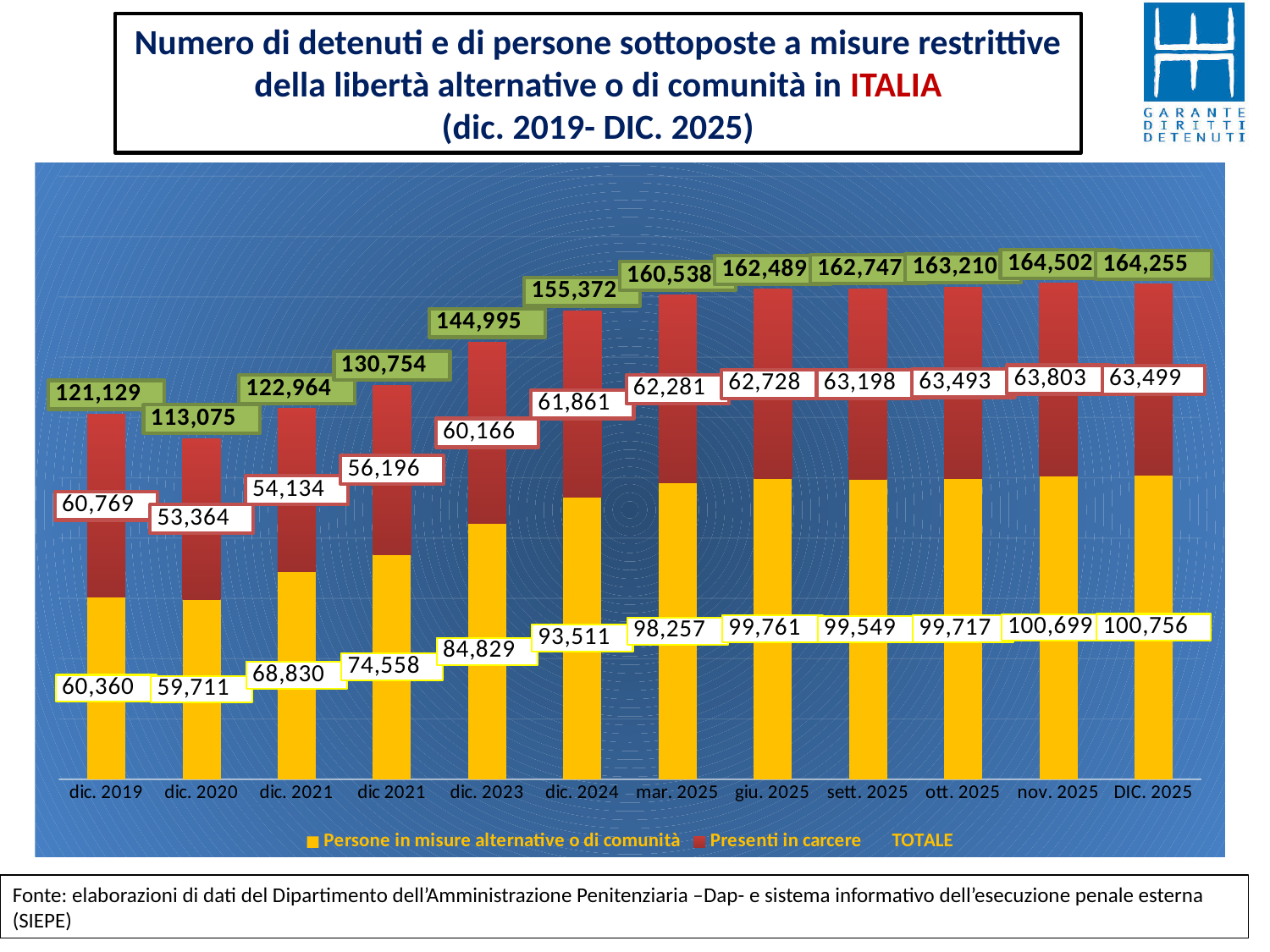
How many series does the legend list? 3 What is the value of 'Persone in misure alternative o di comunità' for dic. 2024? 93,511 What type of chart is shown on the slide? stacked bar chart Which period has the highest TOTALE value? nov. 2025 How many time periods are shown along the x axis? 12 Which period has the lowest TOTALE value? dic. 2020 What is the difference between the 'Presenti in carcere' values for nov. 2025 and DIC. 2025? 304 What is the total of the stacked bar for mar. 2025? 160,538 Does the 'Persone in misure alternative o di comunità' series generally rise or fall from dic. 2020 to DIC. 2025? rise What is the TOTALE value for nov. 2025? 164,502 What is the value of 'Presenti in carcere' for dic. 2019? 60,769 Which is larger for dic. 2020: 'Persone in misure alternative o di comunità' or 'Presenti in carcere'? Persone in misure alternative o di comunità